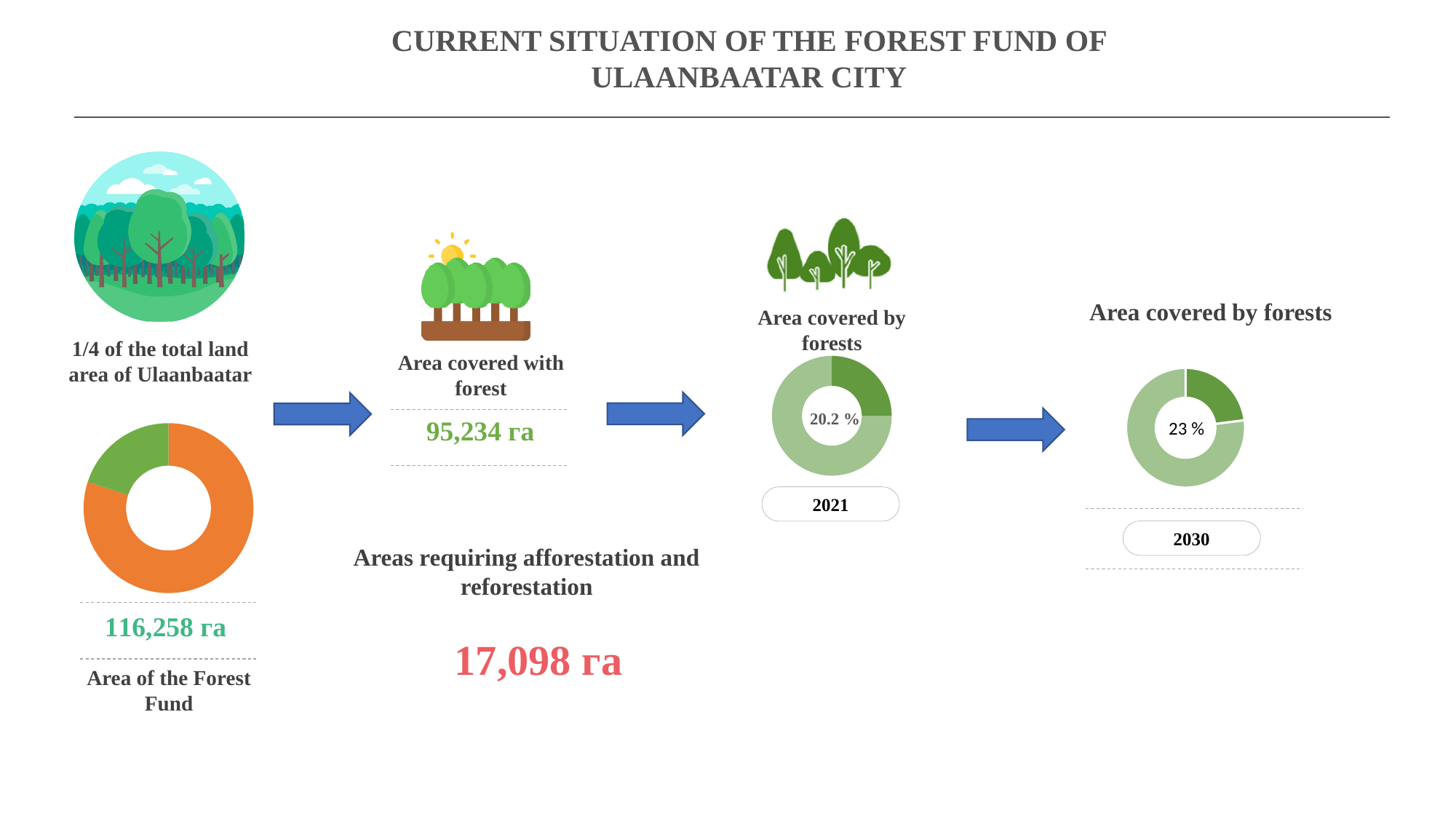
What kind of chart is the 'Area of the Forest Fund' chart on the left of the slide? Donut chart What is the title of the chart labelled 2030 on the right of the slide? Area covered by forests By how many percentage points does the 'Area covered by forests' value for 2030 exceed the value for 2021? 2.8 How many donut charts are shown on the slide? 3 Does the 'Area covered by forests' percentage rise or fall from 2021 to 2030? Rise In the 'Area of the Forest Fund' donut chart on the left, which colour slice is larger, orange or green? Orange What value is printed below the 'Area of the Forest Fund' donut chart on the left? 116,258 га In the 'Area covered by forests' chart for 2021, what percentage is printed in the centre? 20.2 % What kind of chart is shown under the heading 'Area covered by forests' for 2021? Donut chart In the 'Area covered by forests' chart for 2030, what percentage is printed in the centre? 23 % How many slices does the 'Area of the Forest Fund' donut chart on the left have? 2 Which year's 'Area covered by forests' chart shows the larger percentage, 2021 or 2030? 2030